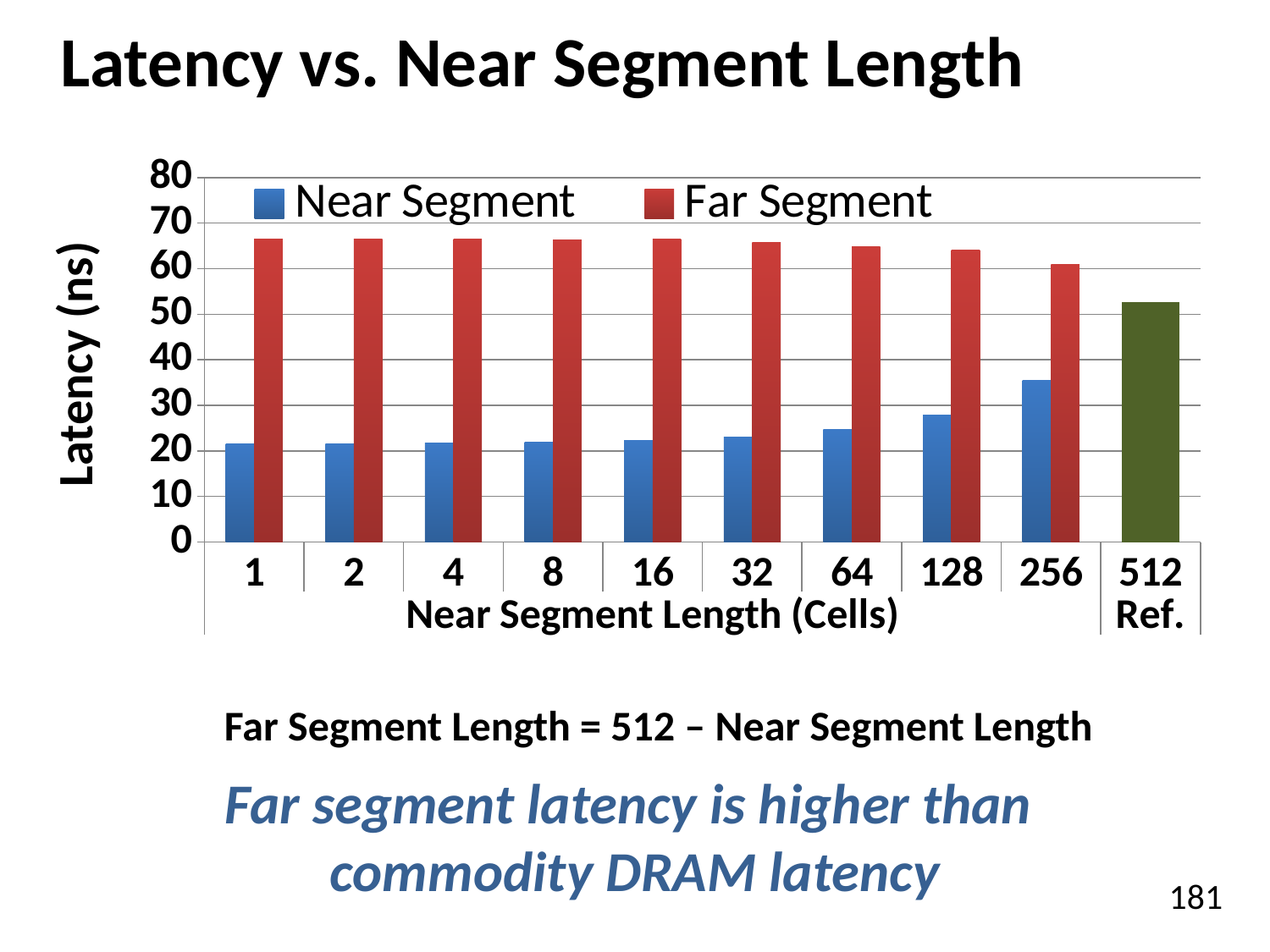
Is the Near Segment latency at near segment length 1 greater or less than 30 ns? less At which near segment length is the Far Segment latency lowest? 256 At which near segment length is the Near Segment latency highest? 256 How many categories are shown along the x axis? 10 How many series does the legend list? 2 Is the latency of the 512 Ref. bar greater or less than 50 ns? greater Is the Far Segment latency at near segment length 1 greater or less than 60 ns? greater Does the Near Segment latency rise or fall as the near segment length increases? rise Which is larger: the Far Segment latency at near segment length 256 or the 512 Ref. latency? Far Segment at 256 Which is larger at near segment length 1: the Near Segment latency or the Far Segment latency? Far Segment What kind of chart is shown on the slide? bar chart